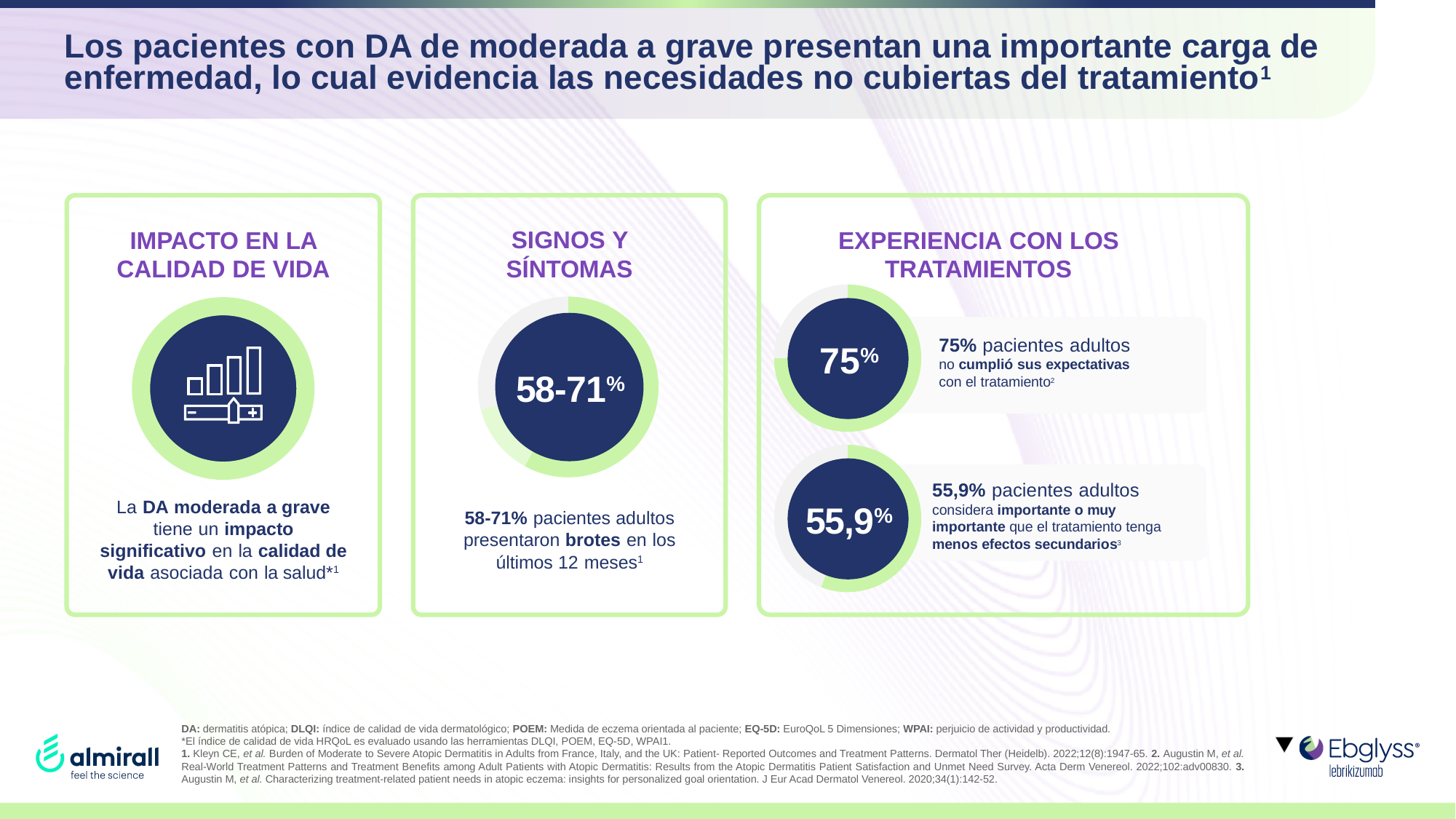
In the 'EXPERIENCIA CON LOS TRATAMIENTOS' panel, what is the difference between the two percentages shown in the ring charts? 19,1% In the 'SIGNOS Y SÍNTOMAS' panel, what percentage is shown in the centre of the ring chart? 58-71% What is the title of the panel containing the 58-71% ring chart? SIGNOS Y SÍNTOMAS In the 'EXPERIENCIA CON LOS TRATAMIENTOS' panel, what percentage is shown in the upper ring chart? 75% In the 'EXPERIENCIA CON LOS TRATAMIENTOS' panel, which ring chart shows the larger value, the upper one or the lower one? the upper one (75%) How many ring charts are shown in the 'EXPERIENCIA CON LOS TRATAMIENTOS' panel? 2 In the 'EXPERIENCIA CON LOS TRATAMIENTOS' panel, what percentage of adult patients consider it important or very important that treatment has fewer side effects? 55,9% In the 'EXPERIENCIA CON LOS TRATAMIENTOS' panel, what percentage of adult patients did not meet their expectations with treatment? 75% What kind of chart is used to display the 75% value in the 'EXPERIENCIA CON LOS TRATAMIENTOS' panel? doughnut (ring) chart In the 'SIGNOS Y SÍNTOMAS' panel, over what period did 58-71% of adult patients present flare-ups? the last 12 months In the 'EXPERIENCIA CON LOS TRATAMIENTOS' panel, what percentage is shown in the lower ring chart? 55,9%